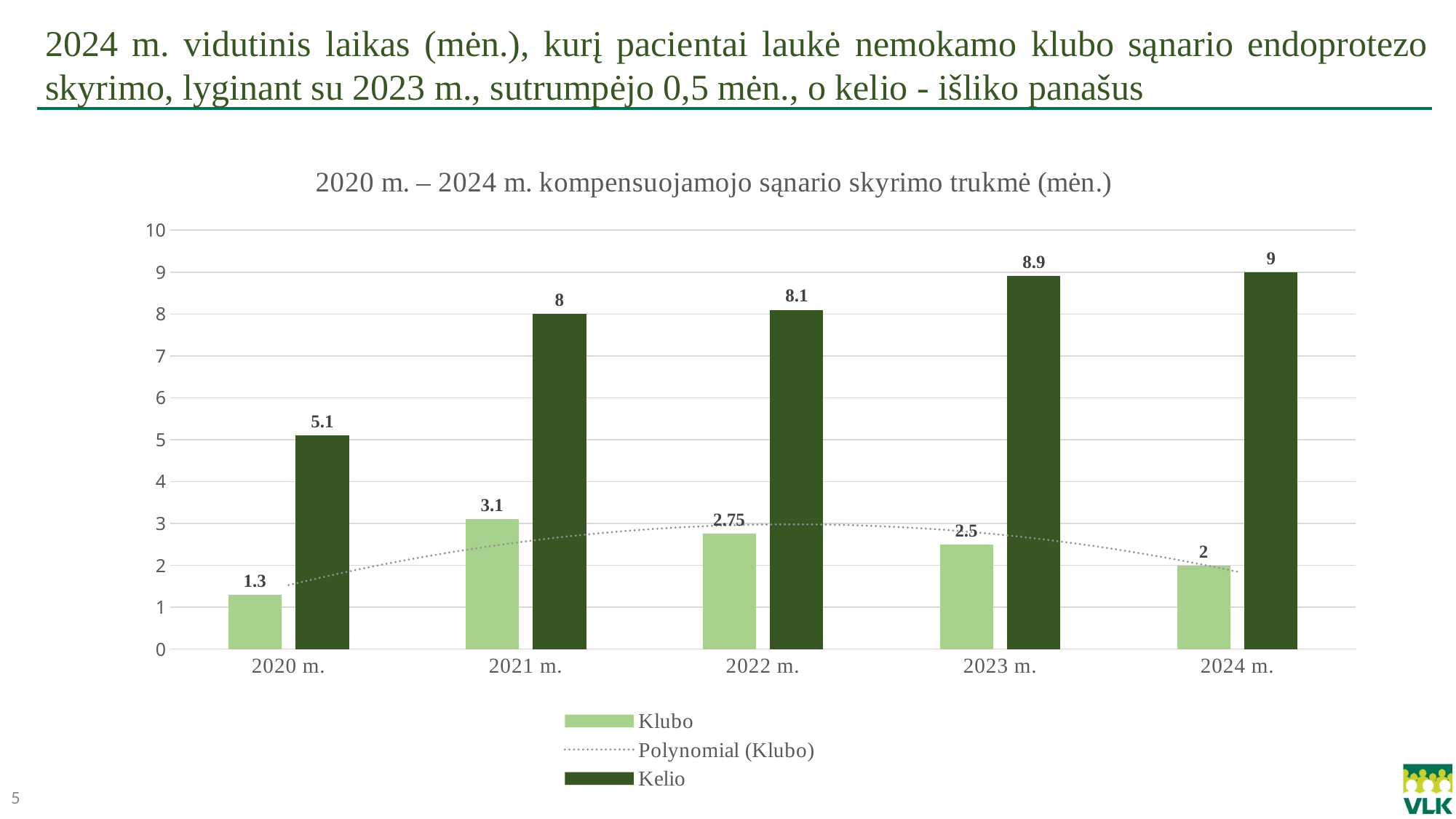
Which is larger: the Klubo value for 2021 m. or for 2022 m.? 2021 m. Which year has the lowest Klubo value? 2020 m. What is the Klubo value for 2024 m.? 2 How many entries does the legend list? 3 Do the Kelio values rise or fall from 2020 m. to 2024 m.? rise What is the difference between the Kelio and Klubo values in 2020 m.? 3.8 What is the Klubo value for 2021 m.? 3.1 What kind of chart is shown? bar chart Which year has the highest Kelio value? 2024 m. What is the Kelio value for 2023 m.? 8.9 What is the difference between the Klubo values for 2023 m. and 2024 m.? 0.5 How many years are shown on the x axis? 5